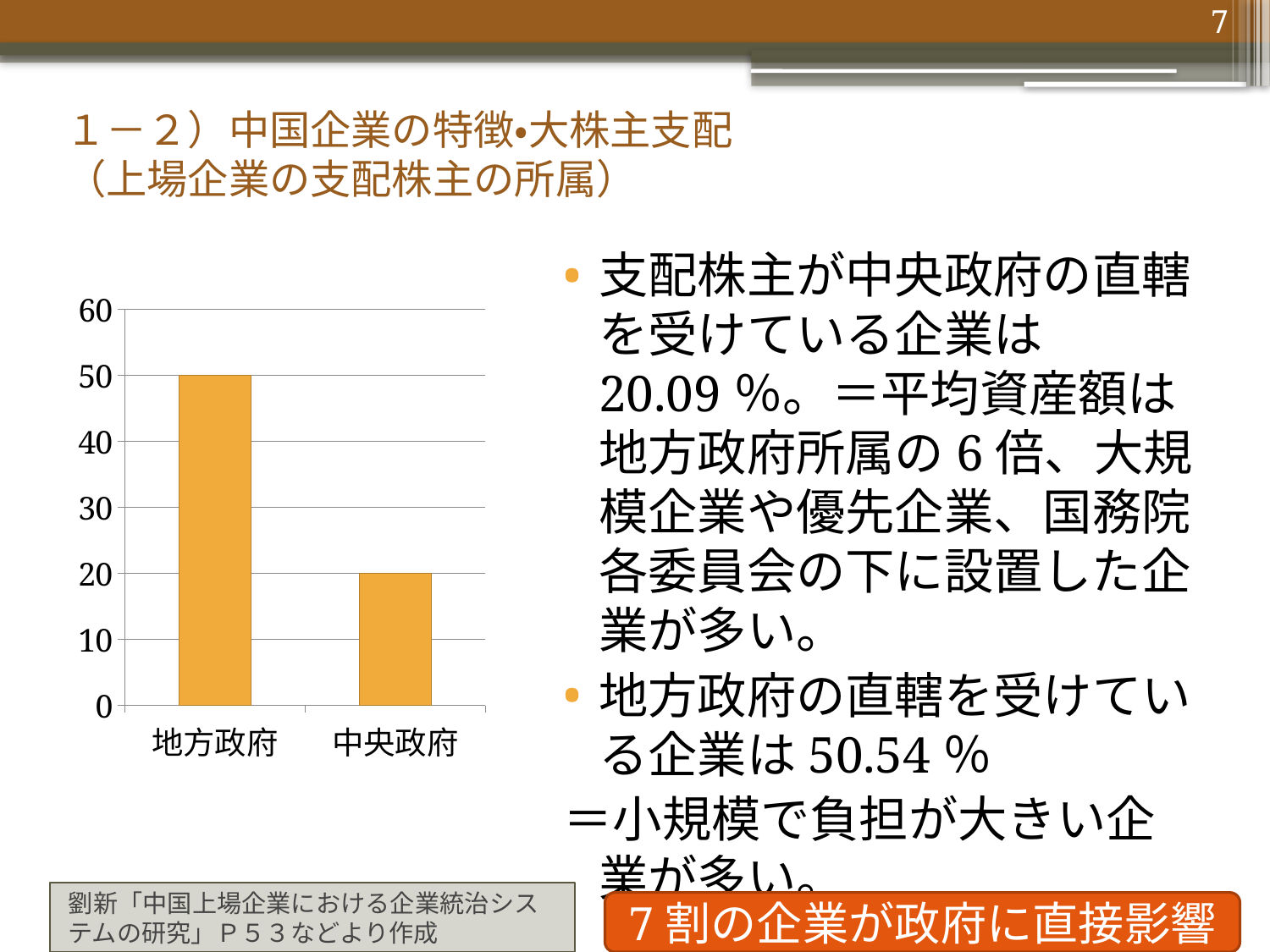
Is the value for 中央政府 greater or less than 10? greater Which is larger in the chart, the value for 地方政府 or the value for 中央政府? 地方政府 What kind of chart is shown on the slide? bar chart How many categories are plotted in the bar chart? 2 Is the value for 中央政府 greater or less than 30? less Do the bar values rise or fall from left to right along the x axis? fall What colour are the bars in the chart? orange Which category has the highest bar in the chart? 地方政府 What is the highest value shown on the vertical axis of the chart? 60 Which category has the lowest bar in the chart? 中央政府 Is the value for 地方政府 greater or less than 60? less